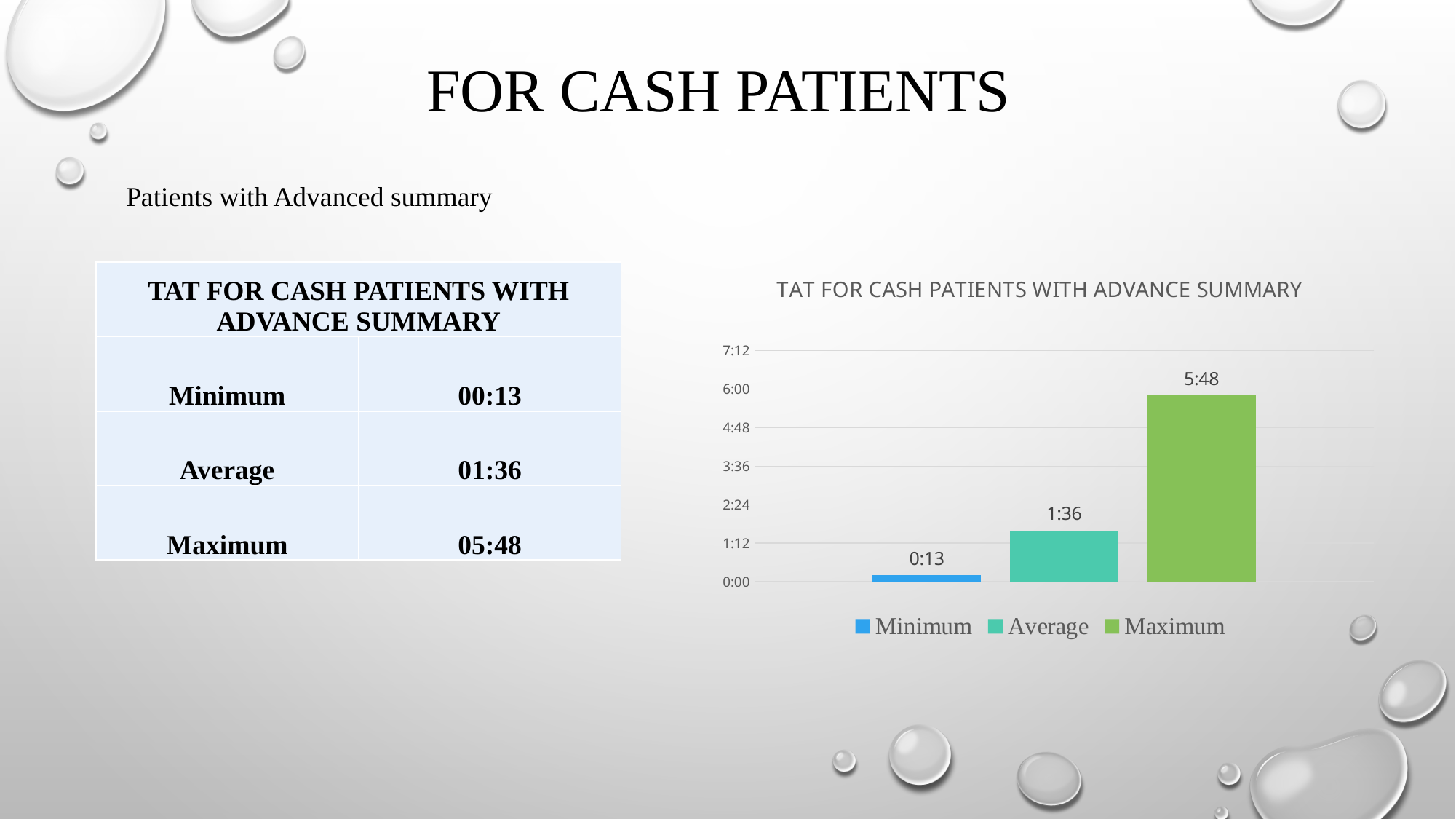
How many bars are plotted in the chart? 3 What is the value shown for Maximum in the chart? 5:48 What is the difference between the Maximum and Average values in the chart? 4:12 Which bar in the chart has the highest value? Maximum Is the value for Minimum greater or less than 1:12? less What is the value shown for Average in the chart? 1:36 How many entries does the chart's legend list? 3 What type of chart is shown on the slide? Bar chart What is the value shown for Minimum in the chart? 0:13 Which is larger in the chart, the Average value or the Minimum value? Average Which bar in the chart has the lowest value? Minimum Is the value for Maximum greater or less than 4:48? greater